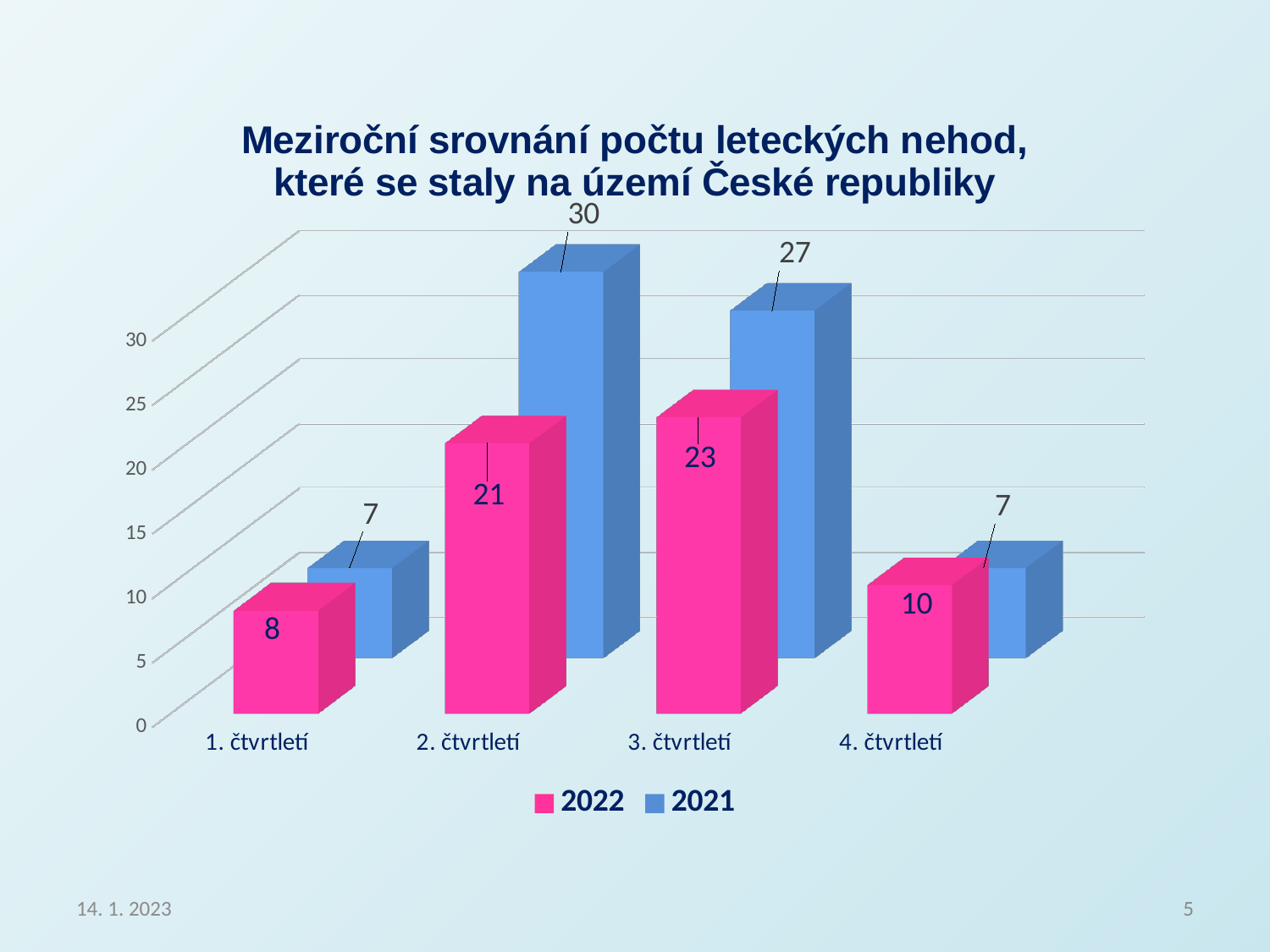
Which is larger in 1. čtvrtletí, the value for 2022 or for 2021? 2022 How many quarters are shown on the x axis? 4 What is the value for 2022 in 4. čtvrtletí? 10 What is the value for 2021 in 3. čtvrtletí? 27 How many series does the legend list? 2 What kind of chart is shown on the slide? bar chart Which quarter has the lowest value for 2022? 1. čtvrtletí What is the total of the 2022 values across all four quarters? 62 Which colour represents the 2022 series in the legend? pink What is the value for 2022 in 2. čtvrtletí? 21 What is the difference between the 2021 and 2022 values in 2. čtvrtletí? 9 Which quarter has the highest value for 2021? 2. čtvrtletí